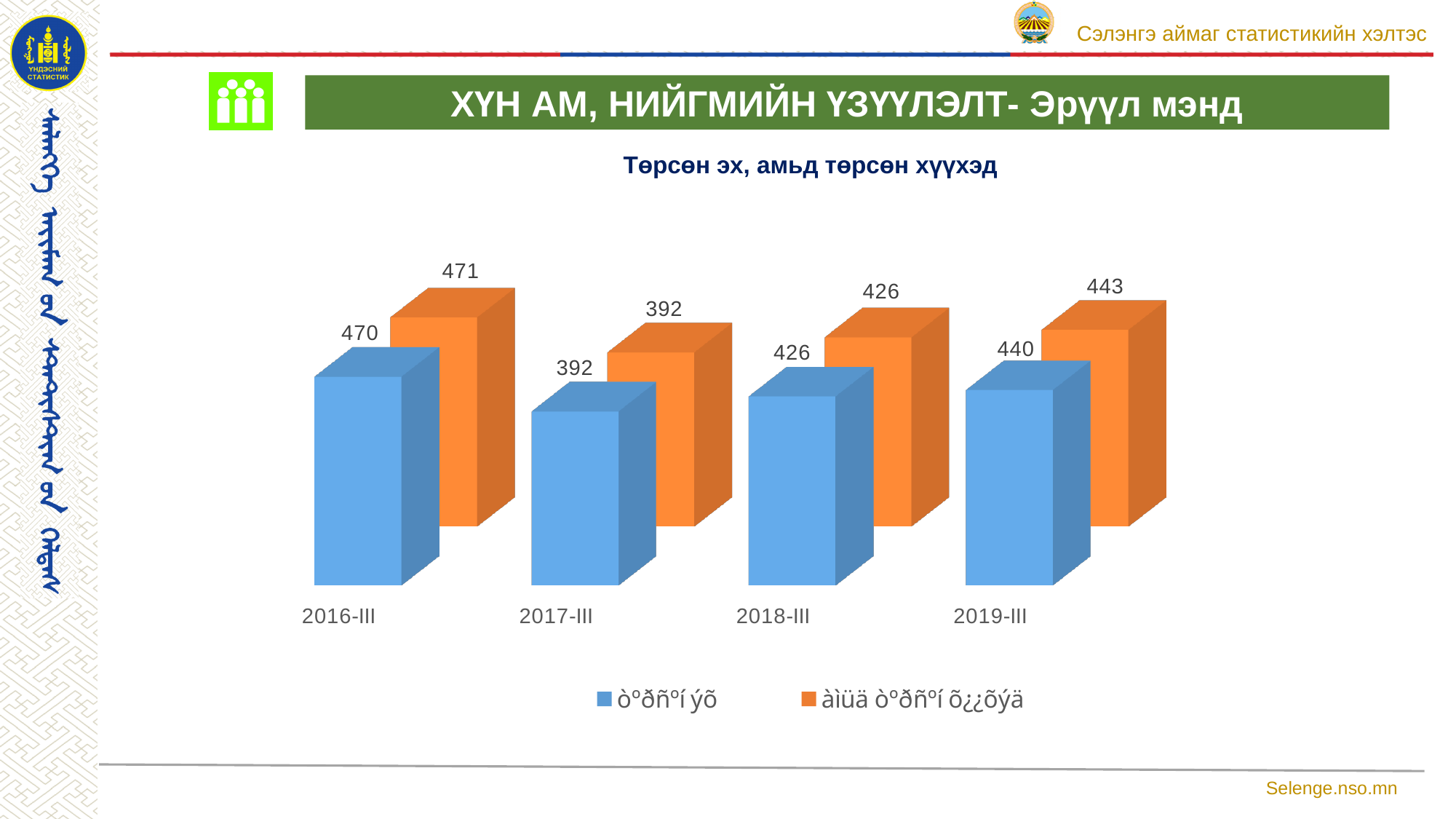
Which category has the highest value for the orange series? 2016-III How many categories are shown on the x axis? 4 Which category has the lowest value for the blue series? 2017-III What is the value of the blue bar for 2016-III? 470 How many series does the legend list? 2 What is the value of the blue bar for 2018-III? 426 What is the difference between the orange bar values for 2019-III and 2018-III? 17 What is the value of the orange bar for 2017-III? 392 What type of chart is shown on the slide? Bar chart Which is larger: the blue bar for 2016-III or the blue bar for 2019-III? 2016-III What is the difference between the blue bar values for 2016-III and 2017-III? 78 What is the value of the orange bar for 2019-III? 443